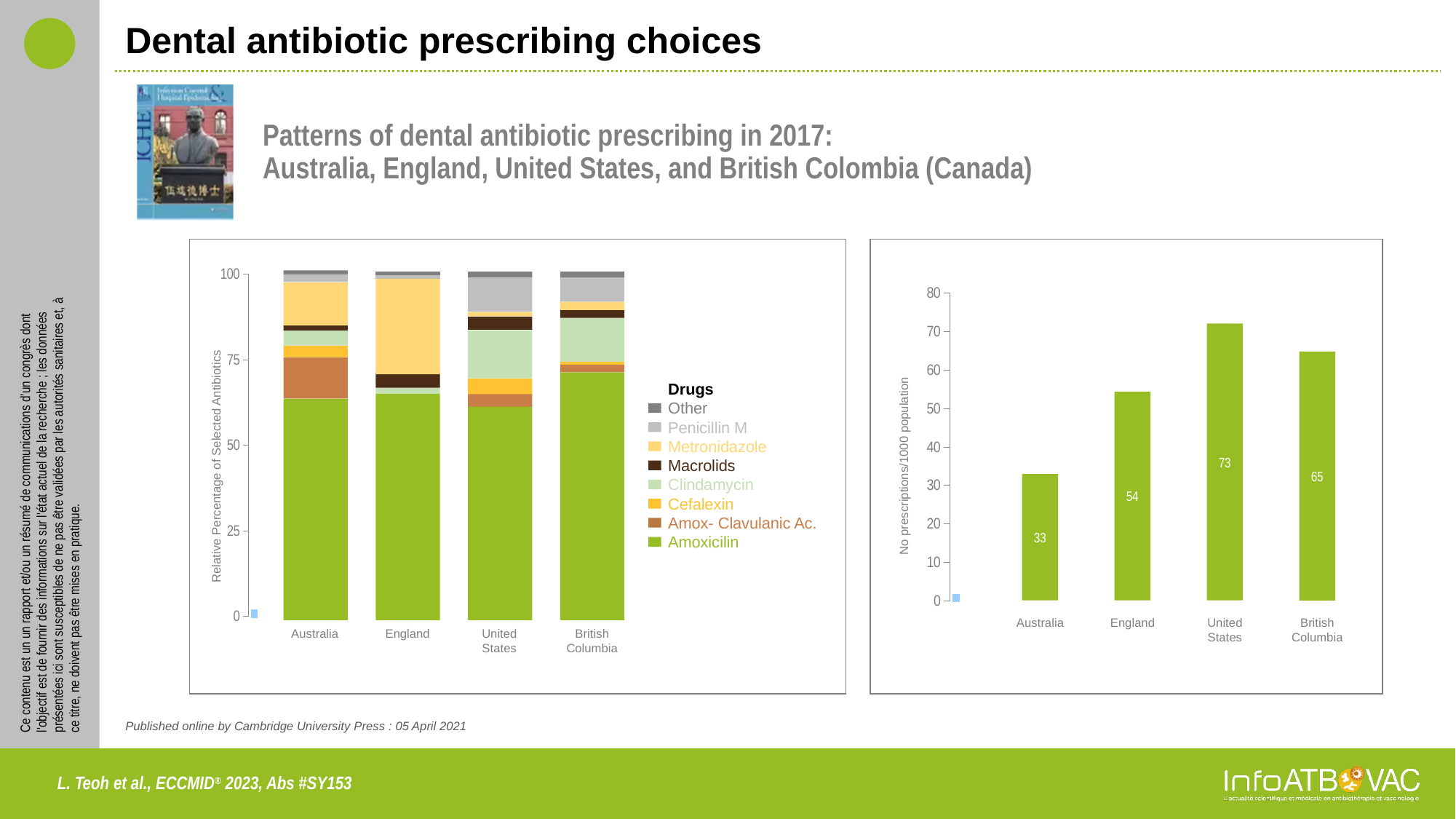
In the right-hand chart (No prescriptions/1000 population), which country has the lowest number of prescriptions per 1000 population? Australia In the right-hand chart (No prescriptions/1000 population), what is the value for Australia? 33 In the left-hand chart (Relative Percentage of Selected Antibiotics), is the Amoxicilin share for Australia greater or less than 50? greater In the right-hand chart (No prescriptions/1000 population), what is the difference between the values for the United States and Australia? 40 In the right-hand chart (No prescriptions/1000 population), what is the difference between the values for British Columbia and England? 11 What kind of chart is the left-hand chart (Relative Percentage of Selected Antibiotics)? Stacked bar chart In the right-hand chart (No prescriptions/1000 population), which is larger, the value for England or the value for British Columbia? British Columbia In the right-hand chart (No prescriptions/1000 population), what is the value for England? 54 How many drugs does the legend of the left-hand stacked chart (Relative Percentage of Selected Antibiotics) list? 8 In the right-hand chart (No prescriptions/1000 population), which country has the highest number of prescriptions per 1000 population? United States In the left-hand chart (Relative Percentage of Selected Antibiotics), which drug is shown in the bottom segment of each bar? Amoxicilin How many countries are shown on the x axis of the right-hand chart (No prescriptions/1000 population)? 4